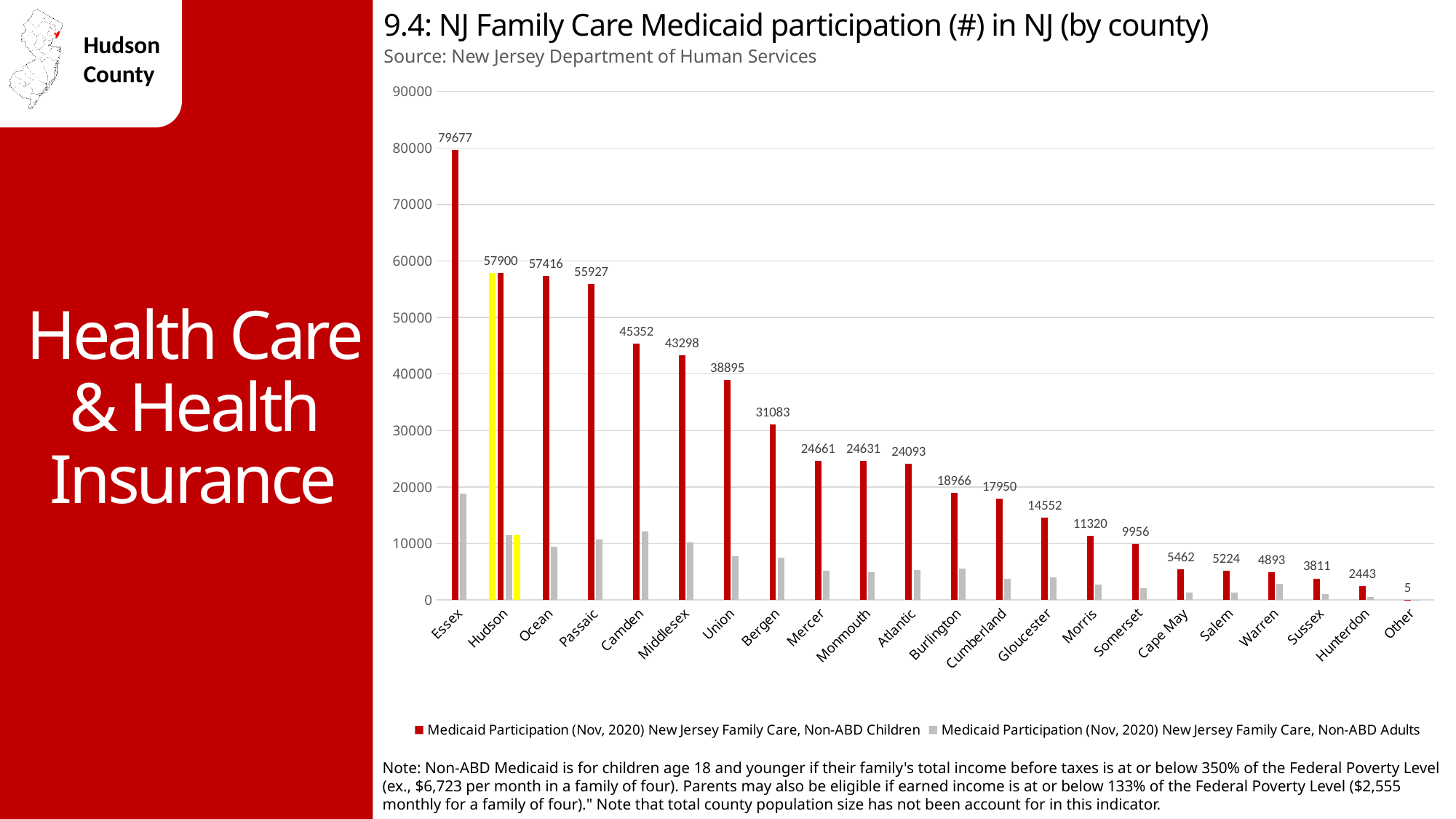
Which has a larger Non-ABD Children value, Union or Bergen? Union How many counties/categories are shown on the x axis? 22 What type of chart is shown on the slide? bar chart How many series does the legend list? 2 Is the Non-ABD Adults value for Union greater or less than 10000? less Which category has the lowest Non-ABD Children Medicaid participation? Other What is the Non-ABD Children Medicaid participation value for Camden? 45352 Which county has the highest Non-ABD Children Medicaid participation? Essex What is the difference between the Non-ABD Children values for Essex and Hudson? 21777 Is the Non-ABD Adults value for Essex greater or less than 10000? greater Do the Non-ABD Children values rise or fall moving from left to right along the x axis? fall What is the Non-ABD Children Medicaid participation value for Hudson? 57900